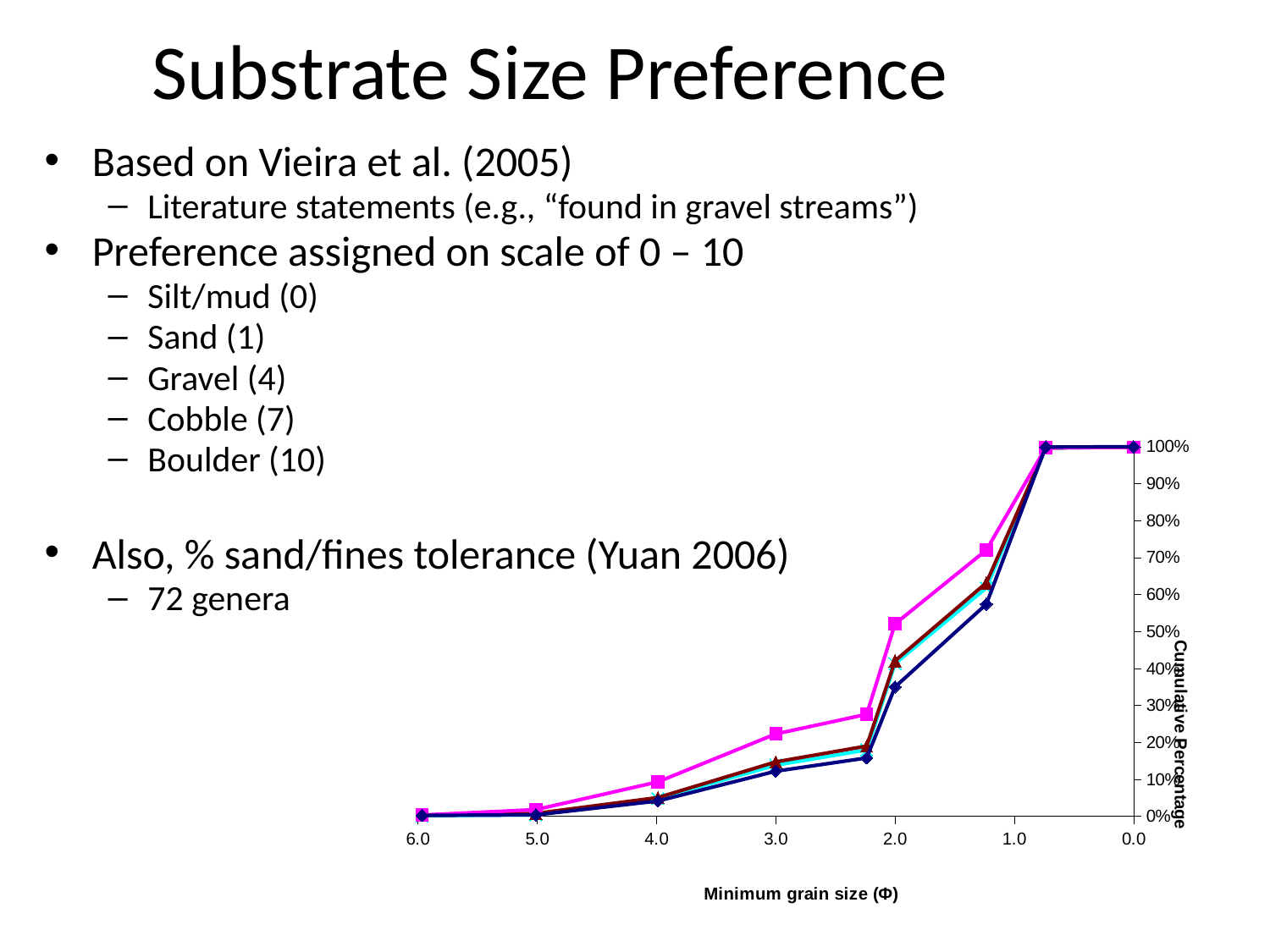
Which line has the highest cumulative percentage at a minimum grain size of 2.0? magenta (square-marker) line Is the value of the dark blue (diamond-marker) line at a minimum grain size of 2.0 greater or less than 50%? less What type of chart is shown on the slide? line chart Is the value of the dark blue (diamond-marker) line at a minimum grain size of 3.0 greater or less than 20%? less At a minimum grain size of 2.0, which line has the higher value: the magenta (square-marker) line or the dark blue (diamond-marker) line? magenta (square-marker) line Is the value of the magenta (square-marker) line at a minimum grain size of 3.0 greater or less than 10%? greater What is the title of the x axis of the chart? Minimum grain size (Φ) What is the title of the y axis of the chart? Cumulative Percentage Do the cumulative percentages rise or fall as the minimum grain size decreases from 6.0 to 0.0 along the x axis? rise